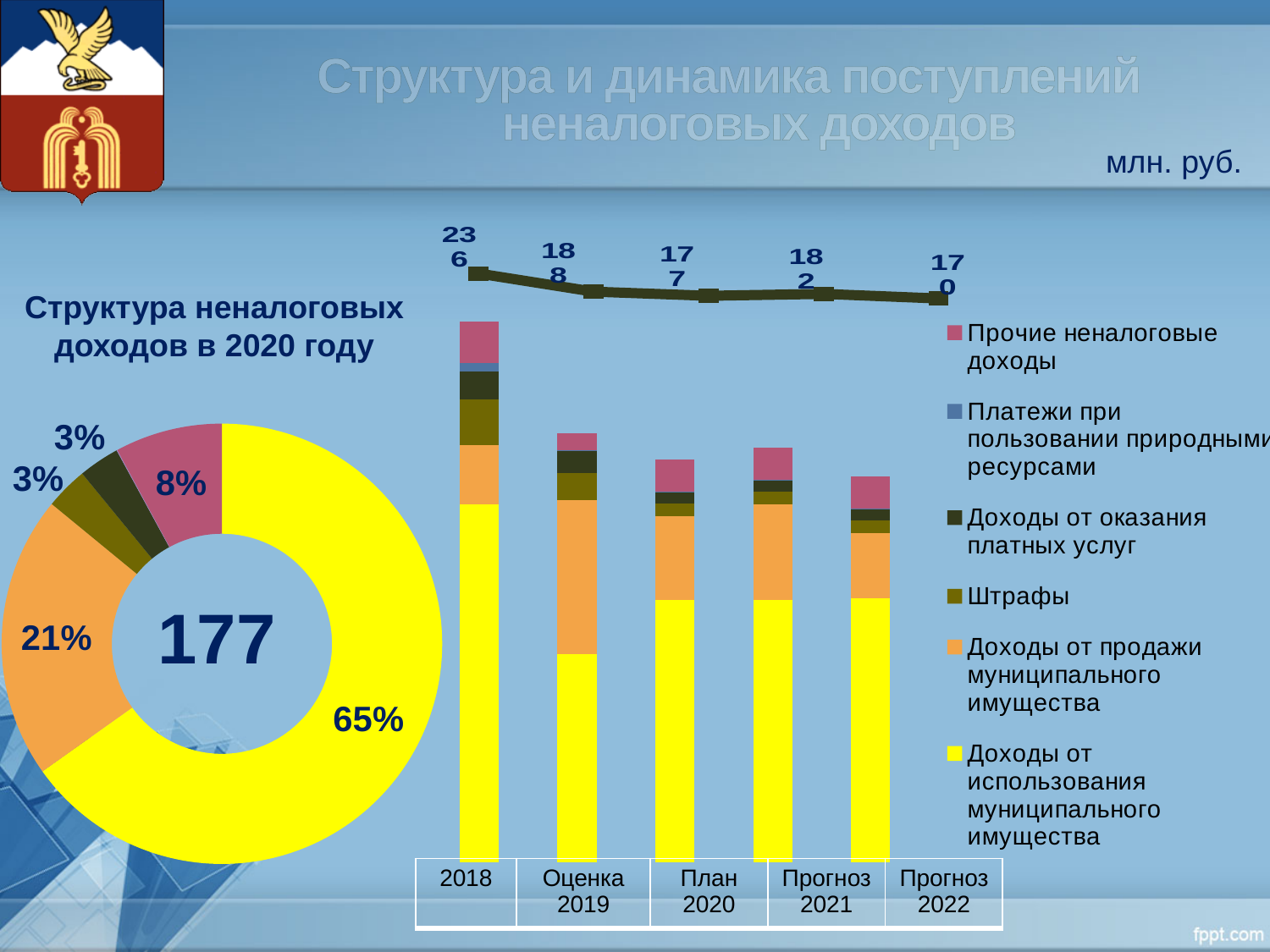
In the donut chart on the left, what share is shown for the orange slice? 21% In the stacked bar chart on the right, which total is larger: 'План 2020' or 'Прогноз 2021'? Прогноз 2021 In the donut chart on the left, what number is shown in the centre? 177 In the stacked bar chart on the right, what is the difference between the totals for 2018 and 'Оценка 2019'? 48 In the stacked bar chart on the right, what total value is shown above the 'Прогноз 2022' bar? 170 In the stacked bar chart on the right, what total value is shown above the 2018 bar? 236 In the stacked bar chart on the right, which category has the lowest total? Прогноз 2022 How many series does the legend of the stacked bar chart on the right list? 6 How many slices does the donut chart on the left have? 5 In the donut chart 'Структура неналоговых доходов в 2020 году', what is the share of the largest slice? 65% In the stacked bar chart on the right, which category has the highest total? 2018 In the donut chart on the left, what share is shown for the pink slice? 8%